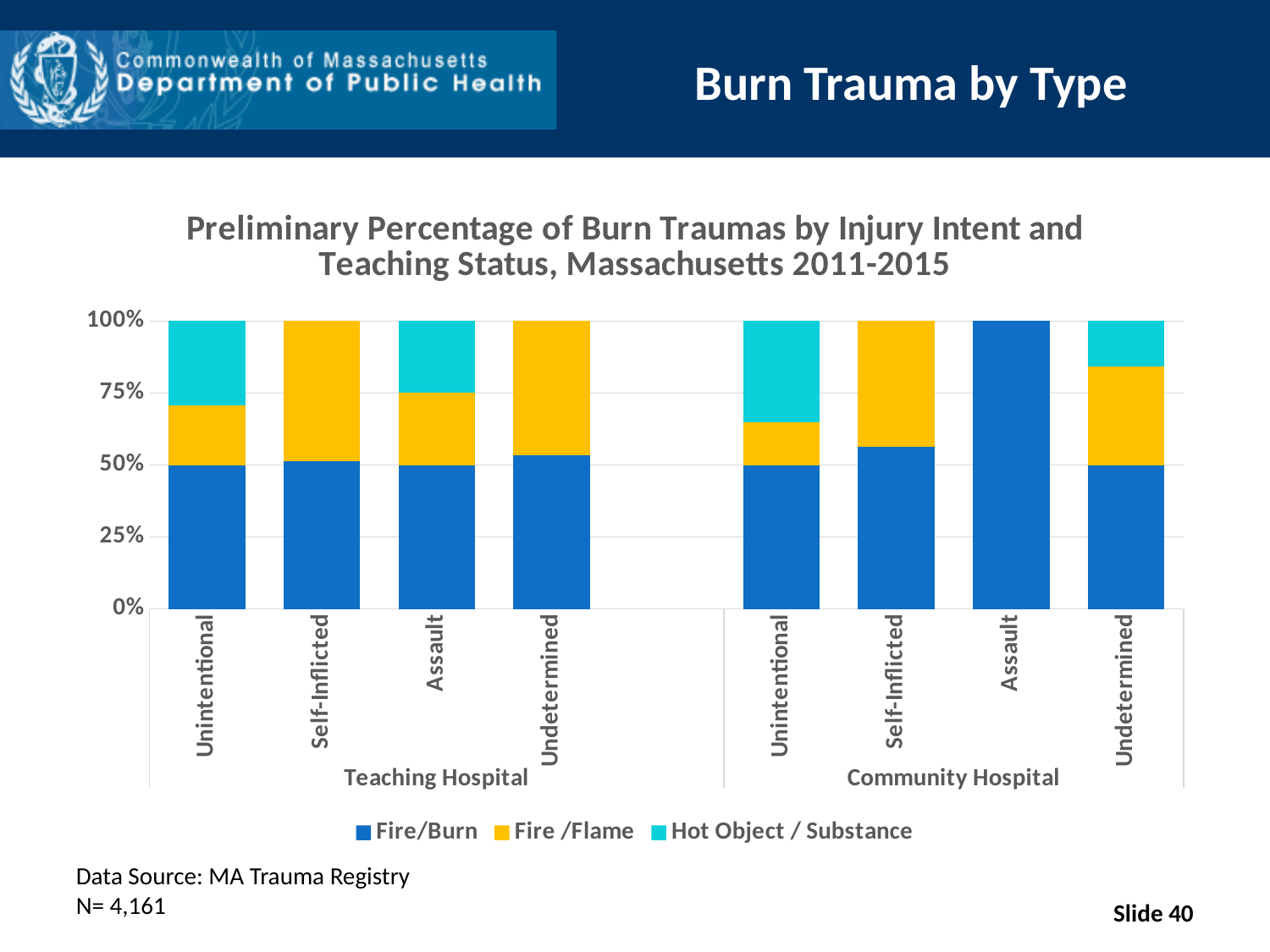
Is the Hot Object / Substance share for Unintentional in Community Hospital greater or less than 25%? greater Which has the larger Fire/Burn share in Community Hospital: Self-Inflicted or Unintentional? Self-Inflicted What is the Fire/Burn share for Assault in Community Hospital? 100% How many injury intent categories are shown under Teaching Hospital? 4 Is the Fire/Burn share for Assault in Community Hospital greater or less than 75%? greater What is the title of the chart? Preliminary Percentage of Burn Traumas by Injury Intent and Teaching Status, Massachusetts 2011-2015 Which Community Hospital category has the highest Fire/Burn share? Assault How many series does the legend list? 3 Is the Fire/Burn share for Self-Inflicted in Community Hospital greater or less than 50%? greater Which series is shown in yellow in the legend? Fire /Flame What kind of chart is shown on the slide? Stacked bar chart How many bars are plotted in the chart? 8